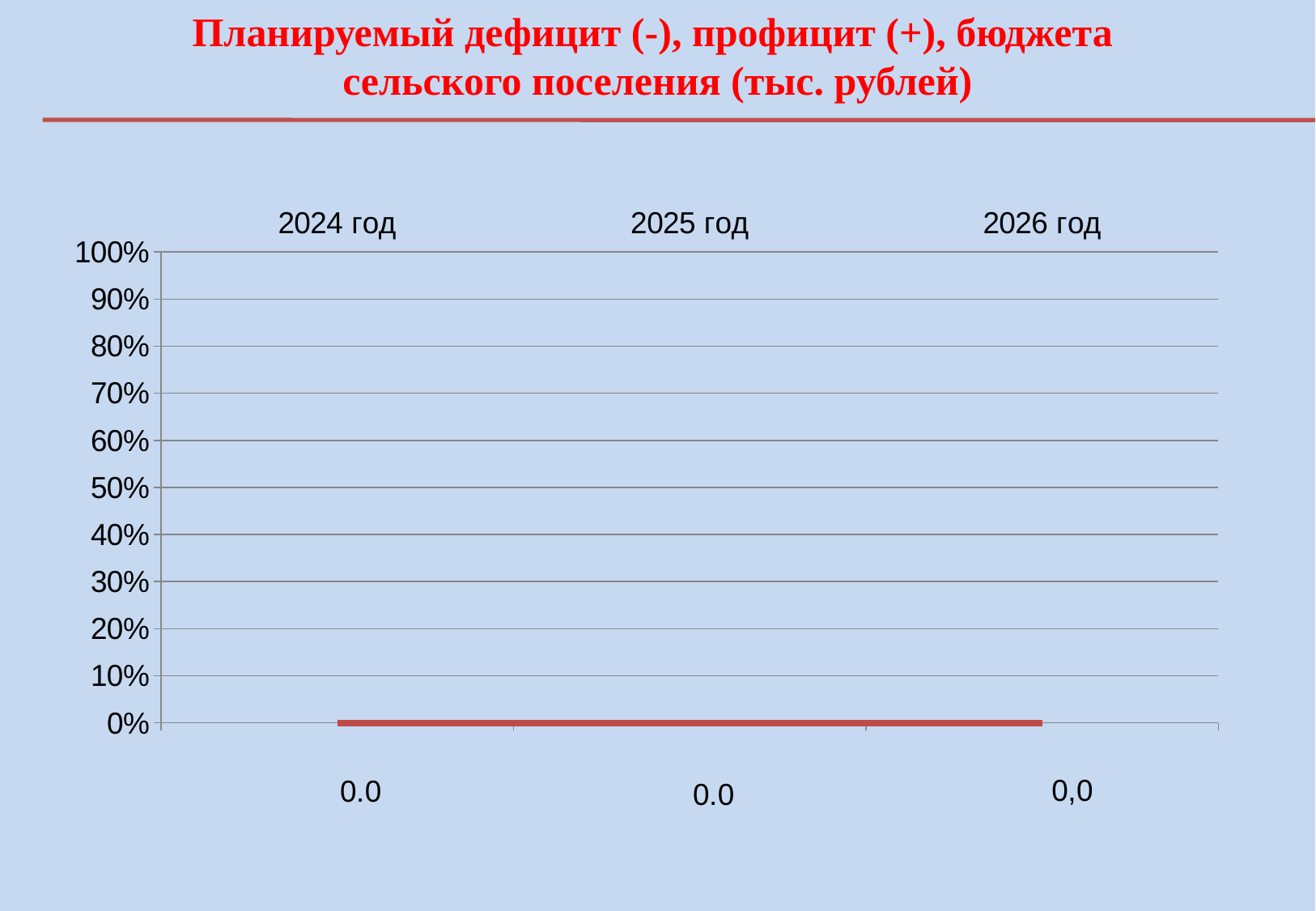
What is the difference between the values for 2024 год and 2025 год? 0.0 How many years (categories) are shown on the chart? 3 Which year is the first category on the x axis? 2024 год Do the values rise, fall, or stay the same from 2024 год to 2026 год? stay the same Is the value for 2025 год greater or less than 50%? less What is the value shown for 2024 год? 0.0 What is the title of the chart? Планируемый дефицит (-), профицит (+), бюджета сельского поселения (тыс. рублей) What is the highest value shown on the vertical axis? 100% What is the value shown for 2025 год? 0.0 What is the value shown for 2026 год? 0,0